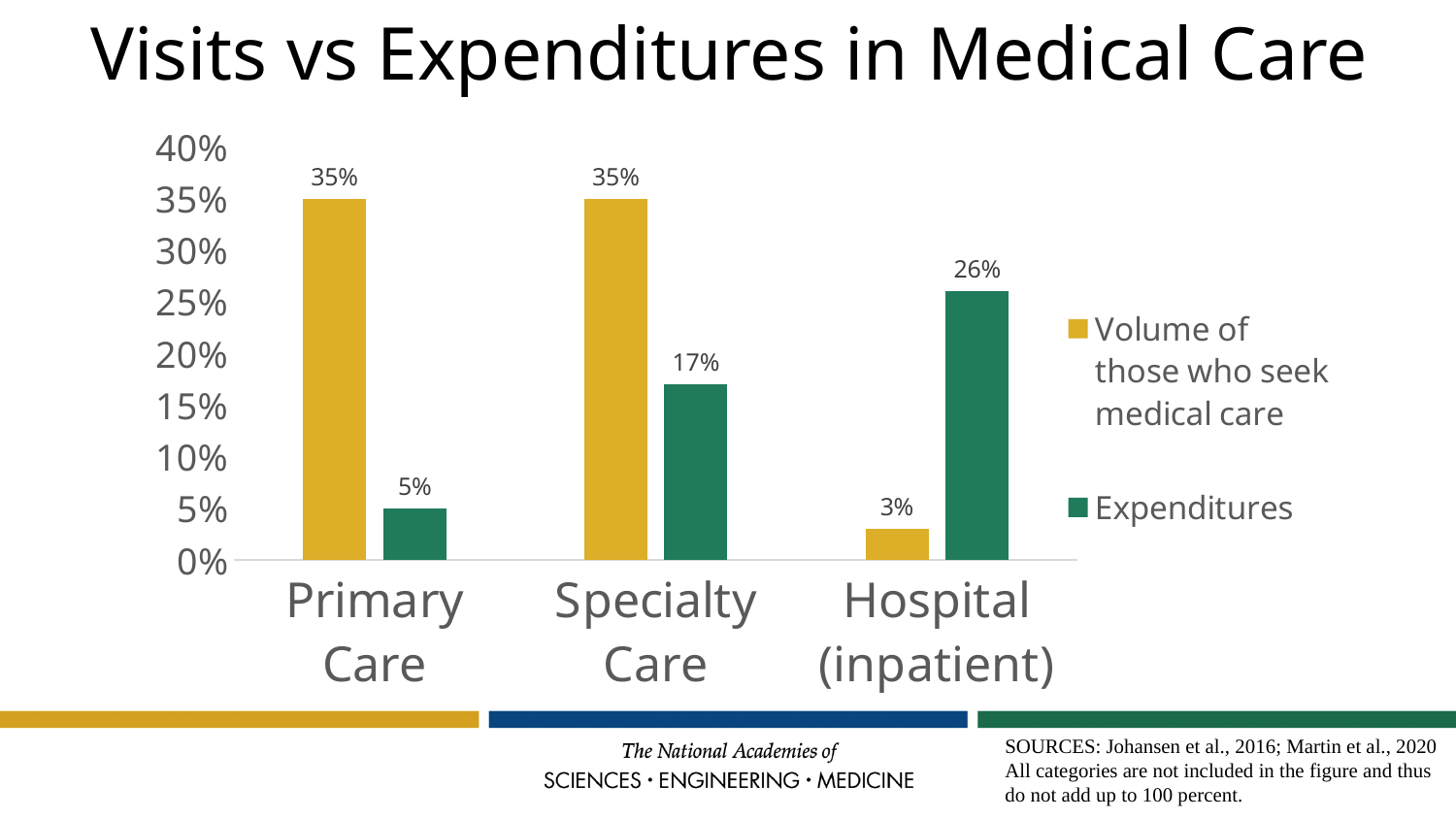
What is the Expenditures value for Hospital (inpatient)? 26% Which category has the highest Expenditures value? Hospital (inpatient) What is the Volume of those who seek medical care value for Primary Care? 35% How many series does the legend list? 2 What is the Volume of those who seek medical care value for Hospital (inpatient)? 3% Is the Expenditures value for Hospital (inpatient) greater or less than 20%? greater How many categories are shown on the x axis? 3 What is the Expenditures value for Specialty Care? 17% What kind of chart is shown on the slide? Bar chart What is the difference between the Volume of those who seek medical care and Expenditures values for Primary Care? 30% Which category has the lowest Volume of those who seek medical care value? Hospital (inpatient) Which is larger for Specialty Care: Volume of those who seek medical care or Expenditures? Volume of those who seek medical care